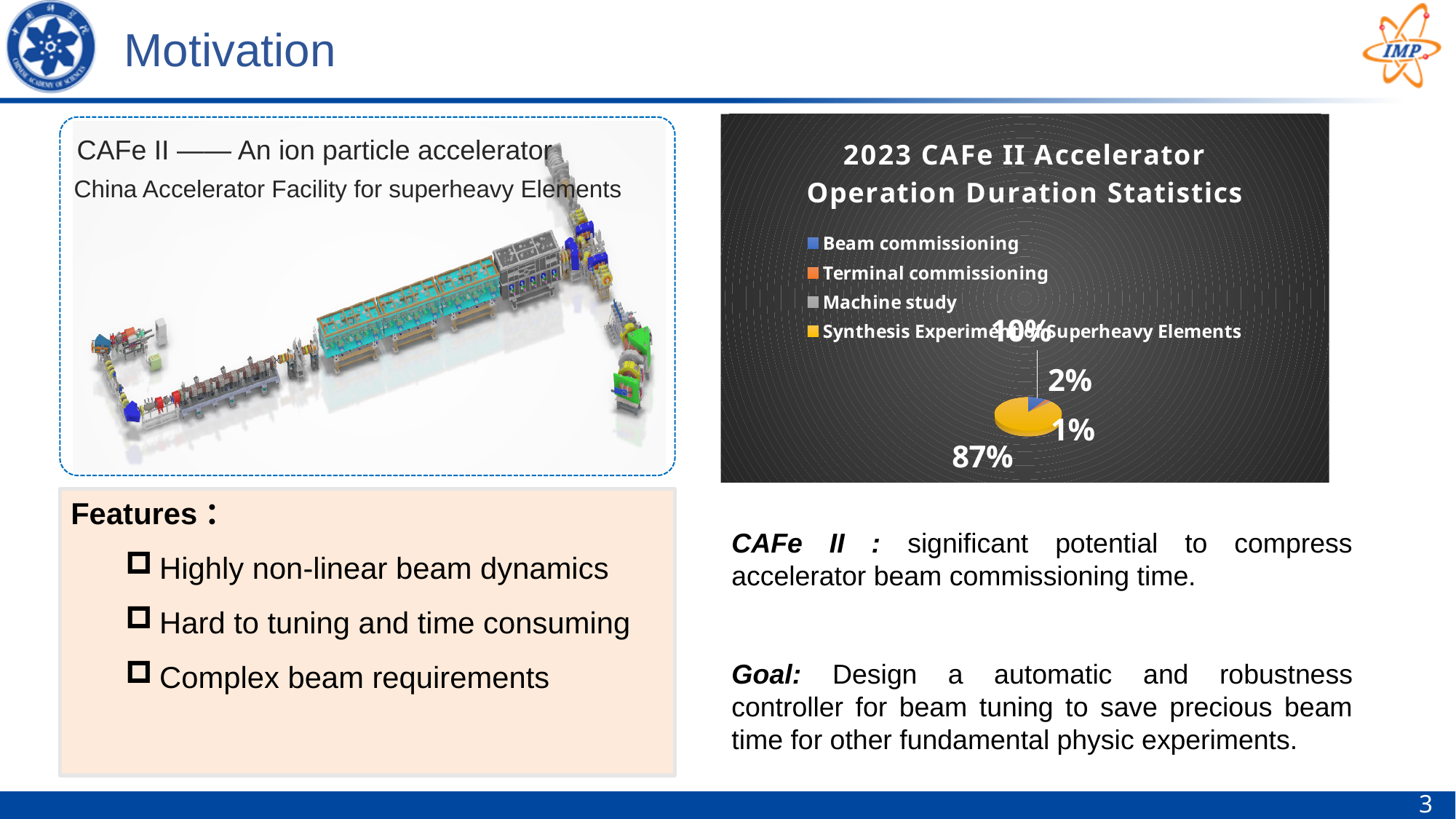
What kind of chart is shown on the slide? pie chart What is the largest percentage label shown on the pie? 87% What is the smallest percentage label shown on the pie? 1% What share of the pie is Synthesis Experiment of Superheavy Elements? 87% How many categories does the chart's legend list? 4 What share of the pie is Beam commissioning? 10% Which category takes the largest share of the pie? Synthesis Experiment of Superheavy Elements What colour represents Synthesis Experiment of Superheavy Elements in the legend? yellow Is the share for Beam commissioning greater or less than 50%? less What is the difference in percentage points between the Synthesis Experiment of Superheavy Elements share and the Beam commissioning share? 77 What is the title of the chart? 2023 CAFe II Accelerator Operation Duration Statistics Which is larger, the share for Beam commissioning or the share for Synthesis Experiment of Superheavy Elements? Synthesis Experiment of Superheavy Elements